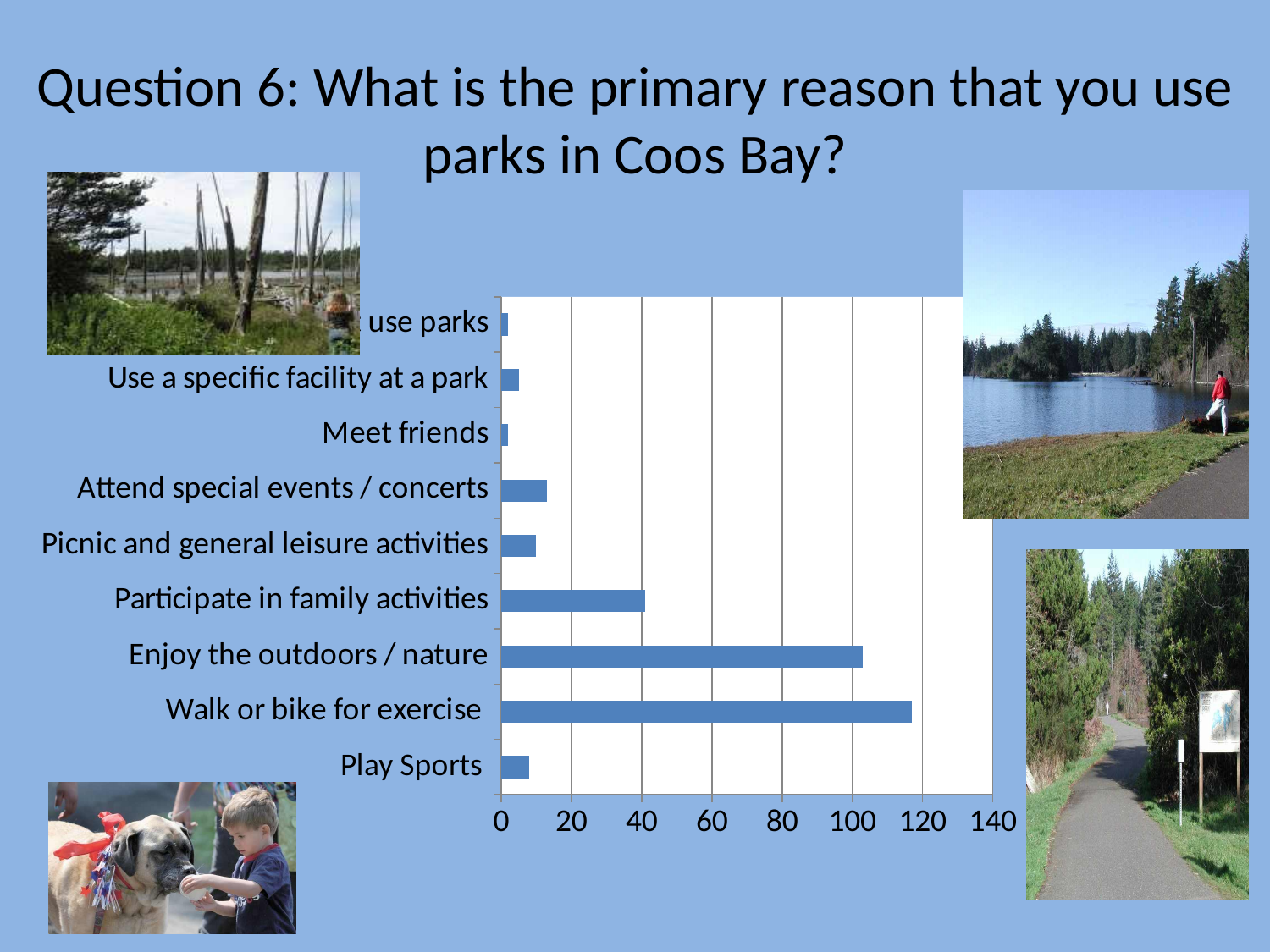
How many bars are plotted in the chart? 9 Is the value for Walk or bike for exercise greater or less than 100? greater Which is larger, the value for Enjoy the outdoors / nature or the value for Participate in family activities? Enjoy the outdoors / nature Is the value for Attend special events / concerts greater or less than 20? less Is the value for Enjoy the outdoors / nature greater or less than 80? greater Which is larger, the value for Walk or bike for exercise or the value for Play Sports? Walk or bike for exercise What kind of chart is shown on the slide? bar chart Which category has the highest value in the chart? Walk or bike for exercise What is the highest value shown on the chart's horizontal axis? 140